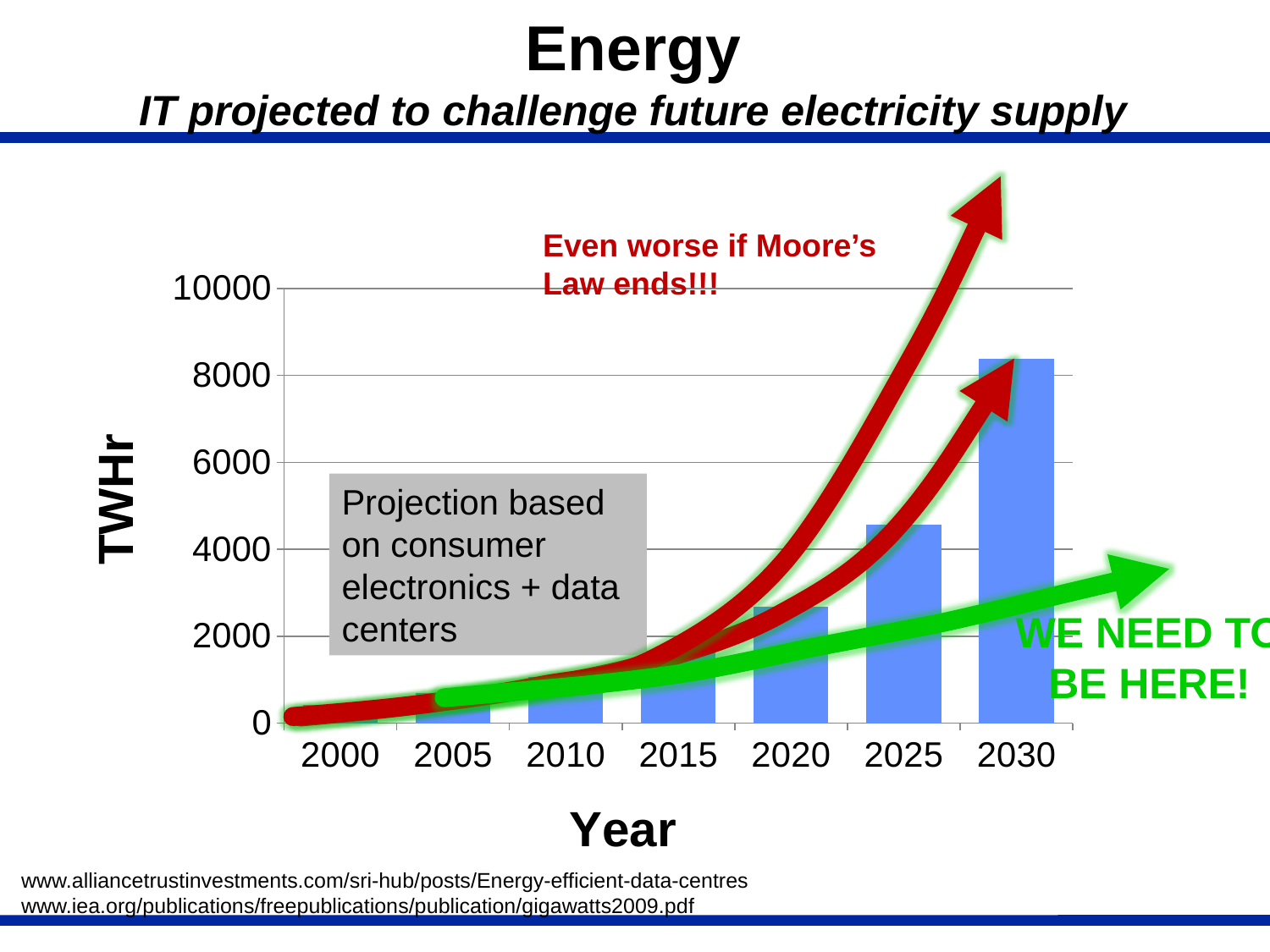
What is the label on the vertical axis of the chart? TWHr Which year has the lowest bar on the chart? 2000 Is the value for 2030 greater or less than 8000? greater Is the value for 2030 greater or less than 10000? less Is the value for 2020 greater or less than 2000? greater Which year has the larger bar, 2020 or 2025? 2025 Which year has the highest bar on the chart? 2030 What kind of chart is shown on the slide? bar chart How many years (bars) are plotted on the chart? 7 Do the bar values rise or fall from 2000 to 2030? rise